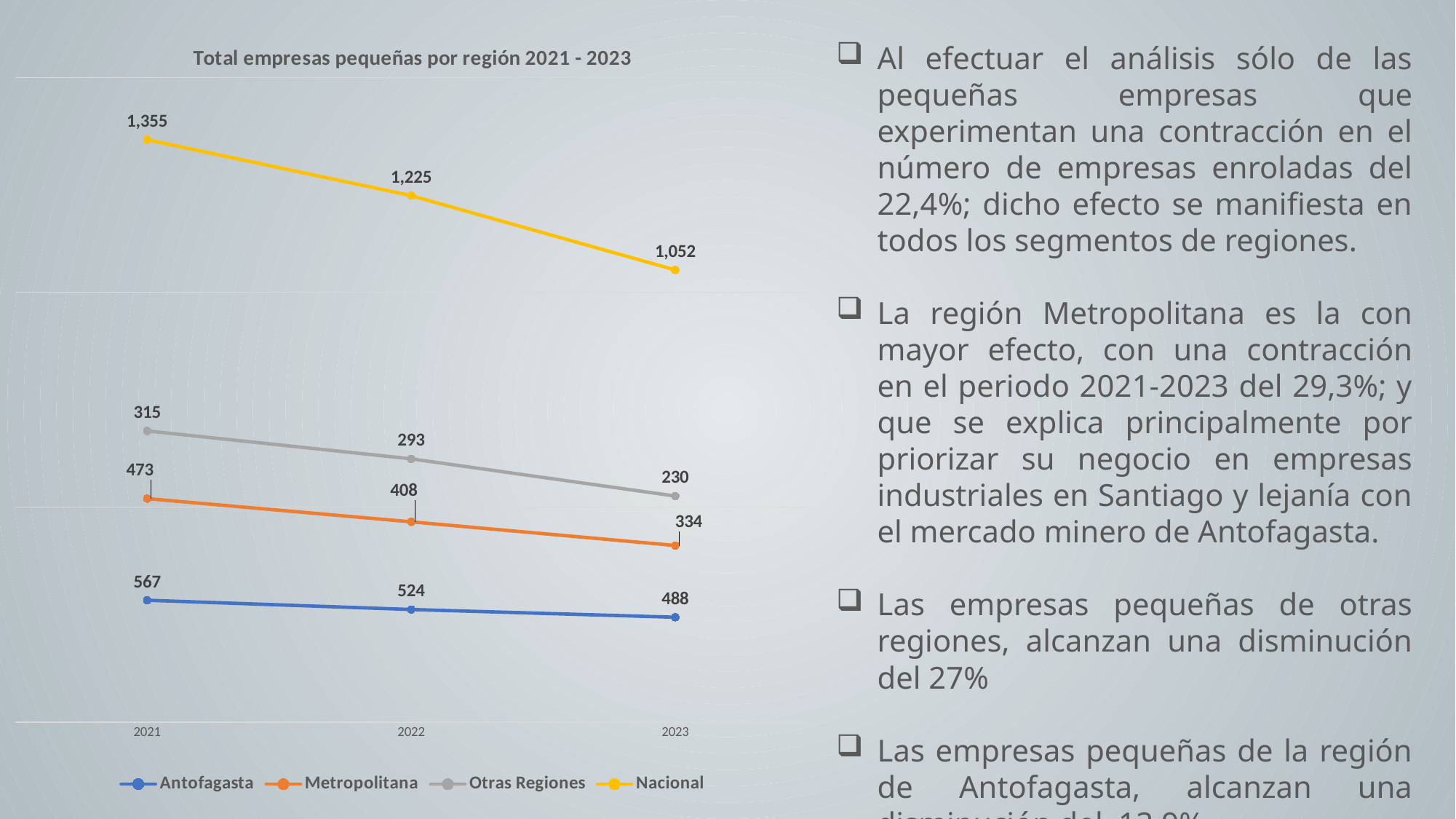
Do the Metropolitana values rise or fall from 2021 to 2023? Fall Which series has the lowest value in 2023? Otras Regiones What kind of chart is shown on the slide? Line chart What is the value for Otras Regiones in 2022? 293 Which series has the highest value in 2023? Nacional What is the value for Nacional in 2021? 1,355 What is the value for Metropolitana in 2023? 334 What is the value for Antofagasta in 2021? 567 What is the difference between the Antofagasta and Metropolitana values in 2022? 116 What is the difference between the Nacional values for 2021 and 2023? 303 Which is larger, the Antofagasta value in 2023 or the Metropolitana value in 2023? Antofagasta How many series does the legend list? 4